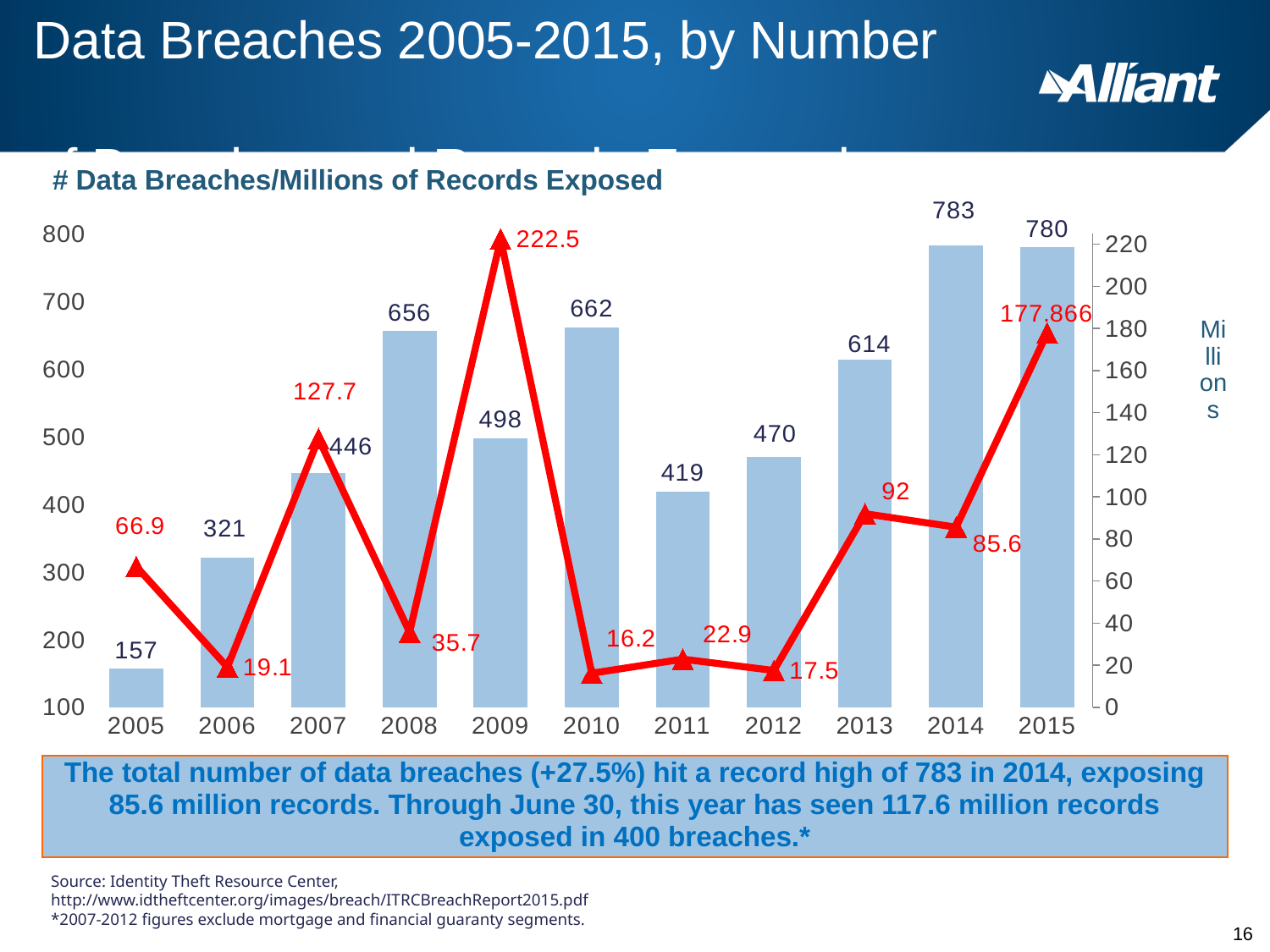
Which year had more data breaches, 2010 or 2009? 2010 Which year has the lowest value for millions of records exposed (line)? 2010 How many millions of records exposed does the line show for 2009? 222.5 What value does the line show for millions of records exposed in 2015? 177.866 Which year has the lowest number of data breaches (bars)? 2005 What is the number of data breaches shown for 2008? 656 What is the difference in the number of data breaches between 2014 and 2013? 169 What is the title of the chart? # Data Breaches/Millions of Records Exposed Which year has the highest number of data breaches (bars)? 2014 Do the bar values for data breaches rise or fall from 2012 to 2014? Rise How many years are shown on the x axis? 11 What kind of chart is this? Combined bar and line chart